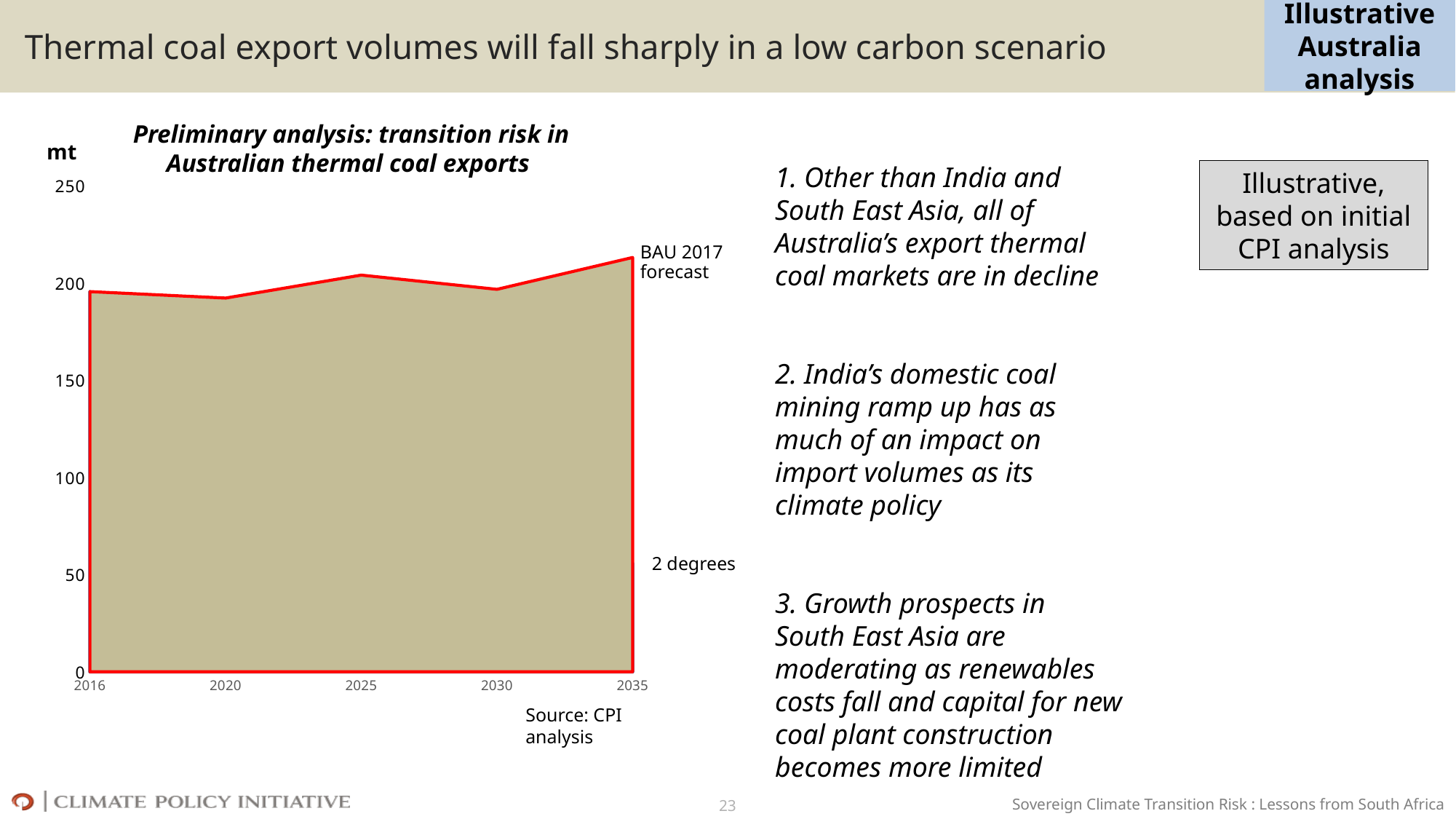
What is the first year shown on the x axis of the chart? 2016 What kind of chart is shown on the slide? Area chart What is the highest value labelled on the y axis of the chart? 250 Is the value for 2030 greater or less than 150? greater Is the value for 2020 greater or less than 200? less Is the value for 2035 greater or less than 200? greater What unit is shown on the y axis of the chart? mt Which year has the highest value on the BAU 2017 forecast line? 2035 Does the BAU 2017 forecast line overall rise or fall from 2016 to 2035? rise How many years are labelled on the x axis of the chart? 5 What is the title of the chart? Preliminary analysis: transition risk in Australian thermal coal exports Which is larger, the value for 2035 or the value for 2020? 2035